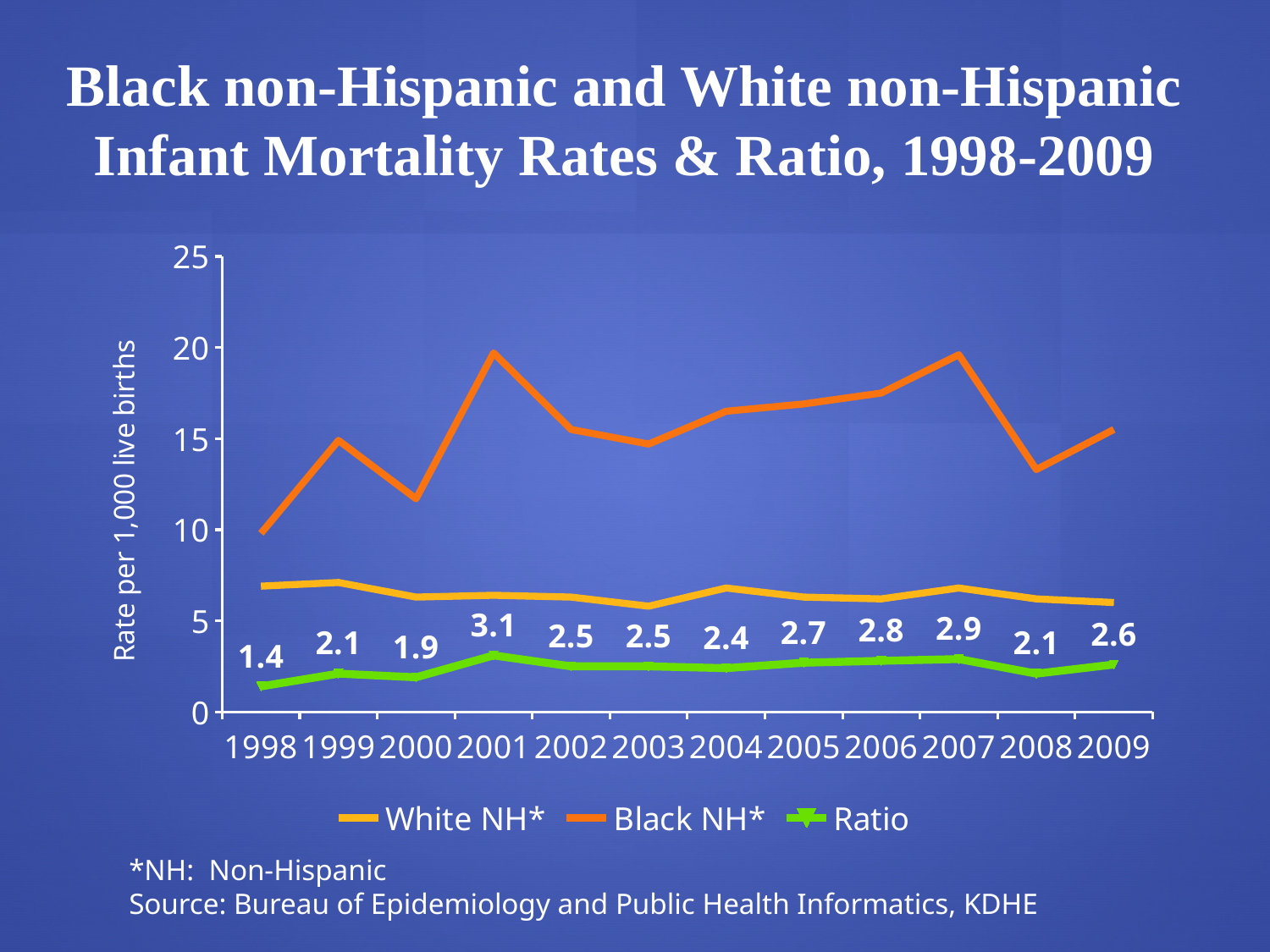
What is the Ratio value for 2001? 3.1 What kind of chart is shown on the slide? Line chart Is the Black NH* rate for 2001 greater or less than 15? greater Which year has a larger Ratio, 2004 or 2005? 2005 What is the Ratio value for 1998? 1.4 In which year is the Ratio highest? 2001 How many years are shown on the x axis? 12 Is the White NH* rate for 1998 greater or less than 10? less How many series does the legend list? 3 In which year is the Ratio lowest? 1998 What is the Ratio value for 2009? 2.6 What is the difference between the highest Ratio (2001) and the lowest Ratio (1998)? 1.7